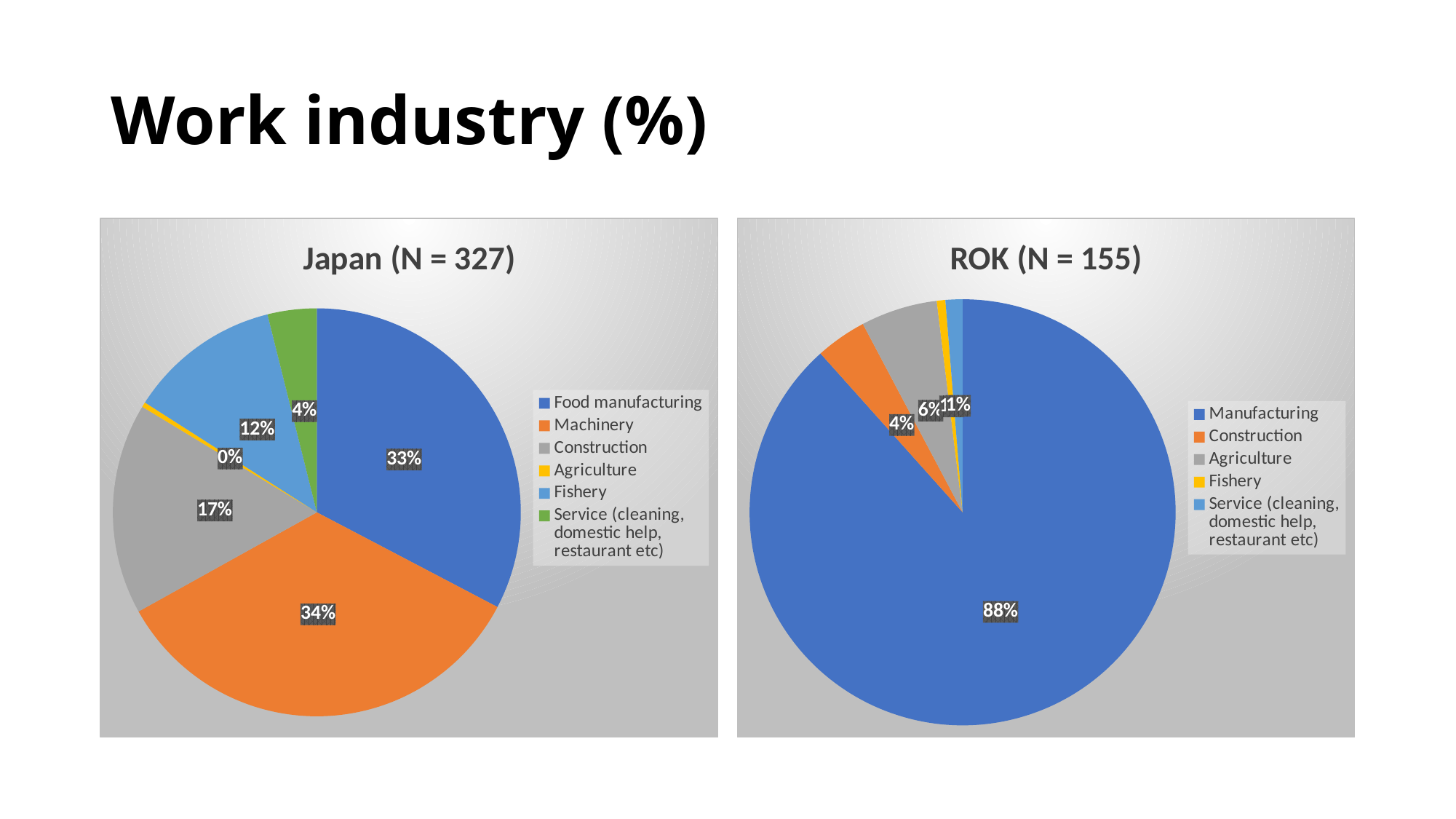
How many categories does the legend of the ROK (N = 155) chart list? 5 What type of chart is the Japan (N = 327) chart? Pie chart In the Japan (N = 327) chart, which category has the smallest share? Agriculture In the Japan (N = 327) chart, what share is Agriculture? 0% In the Japan (N = 327) chart, which is larger, Construction or Fishery? Construction In the ROK (N = 155) chart, which category has the largest share? Manufacturing In the ROK (N = 155) chart, what share is Manufacturing? 88% In the Japan (N = 327) chart, what share is Construction? 17% In the Japan (N = 327) chart, what share is Fishery? 12% In the ROK (N = 155) chart, what share is Construction? 4% In the Japan (N = 327) chart, what is the difference between the Machinery and Food manufacturing shares? 1% In the Japan (N = 327) chart, what share is Machinery? 34%